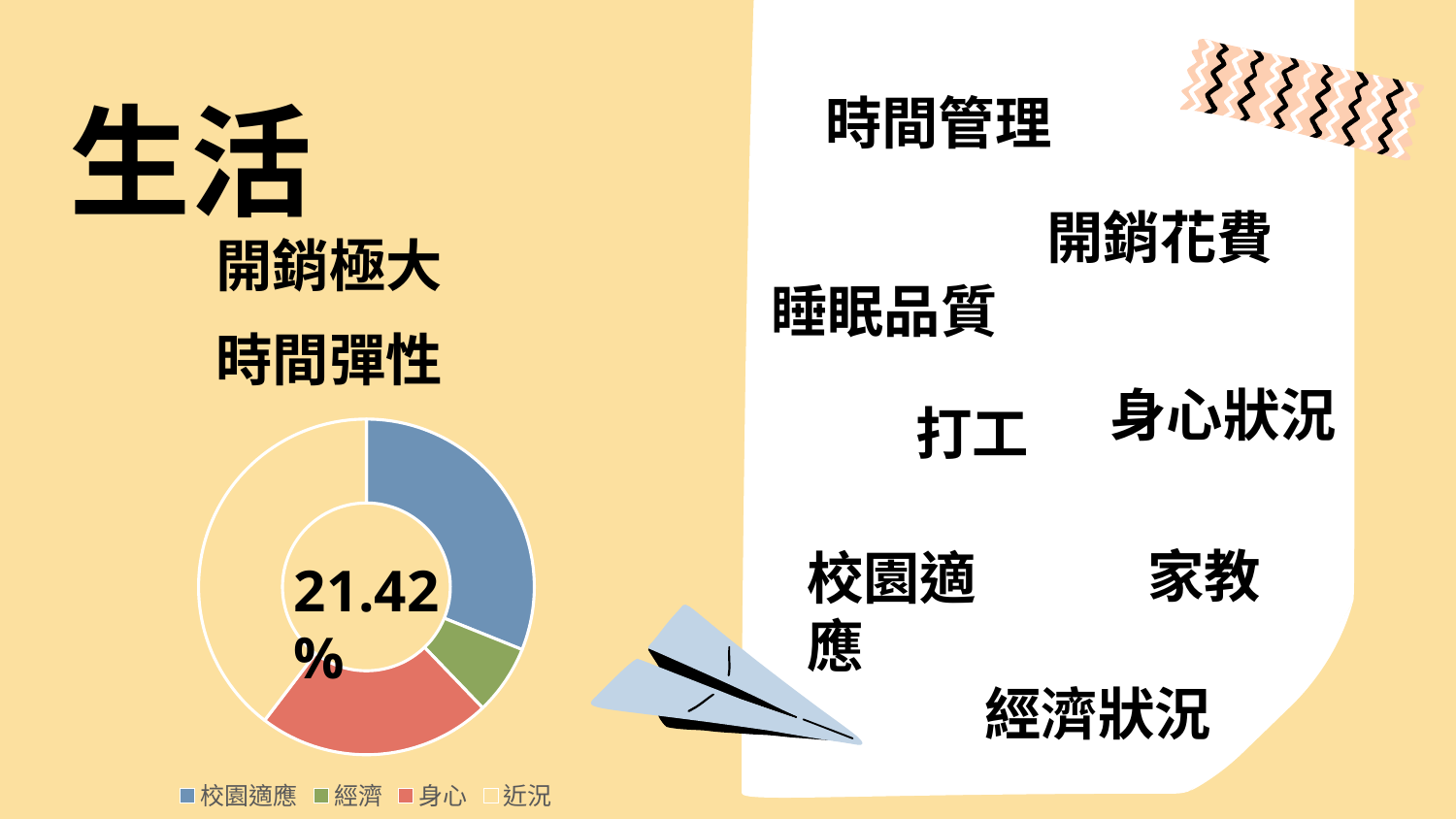
How many categories does the doughnut chart's legend list? 4 Which slice is larger in the doughnut chart, 近況 or 身心? 近況 What kind of chart is shown on the slide? Doughnut (pie) chart Which slice is larger in the doughnut chart, 身心 or 經濟? 身心 Which slice is larger in the doughnut chart, 校園適應 or 身心? 校園適應 Which category has the largest slice in the doughnut chart? 近況 Which category has the smallest slice in the doughnut chart? 經濟 What colour represents 身心 in the doughnut chart? Red What percentage is printed in the centre of the doughnut chart? 21.42%